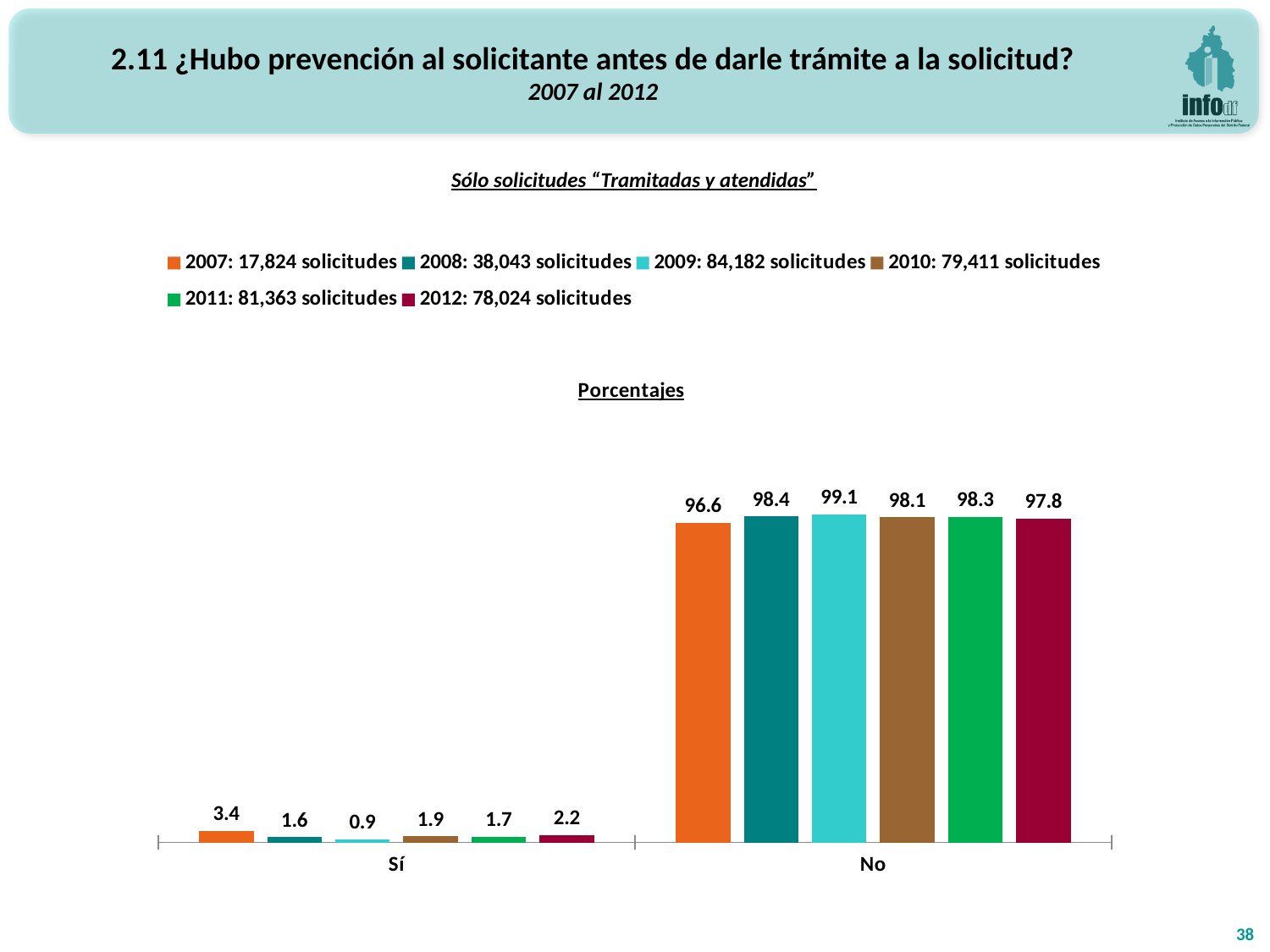
What is the difference between the 2007 and 2009 values in the "Sí" category? 2.5 Which is larger in the "Sí" category: the value for 2010 or the value for 2011? 2010 Which year has the highest value in the "Sí" category? 2007 How many categories are shown on the x axis? 2 Which year has the lowest value in the "Sí" category? 2009 How many series does the legend list? 6 What is the difference between the 2009 and 2007 values in the "No" category? 2.5 What is the value for 2009 in the "No" category? 99.1 What is the value for 2007 in the "Sí" category? 3.4 What kind of chart is shown on the slide? Bar chart Which year has the lowest value in the "No" category? 2007 What is the value for 2012 in the "Sí" category? 2.2